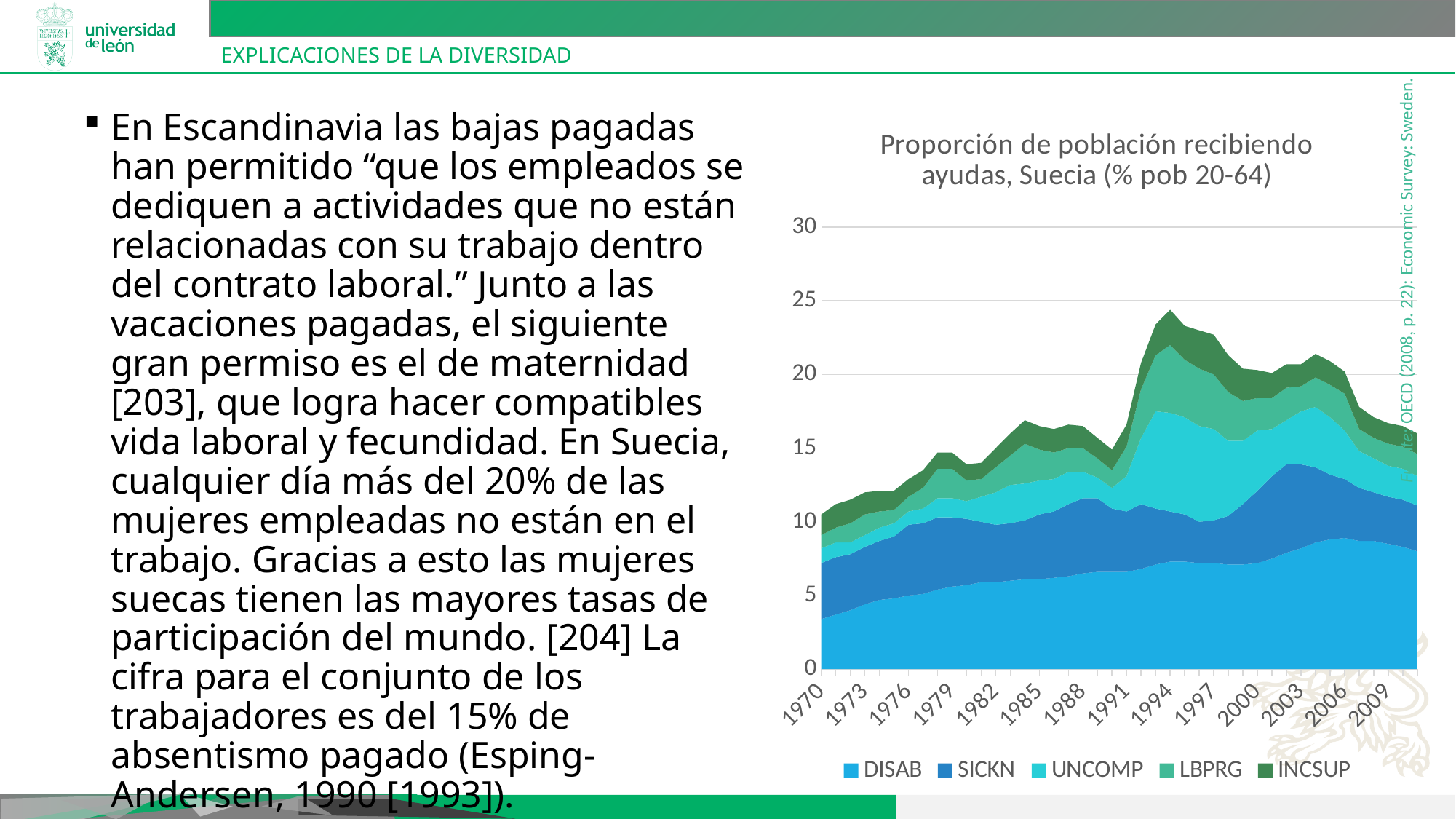
Is the total value for 1994 greater or less than 20? greater Does the total proportion rise or fall between 1970 and 1994? Rises Is the total value for 1994 larger or smaller than the total value for 1970? Larger In which year is the total proportion of population receiving aid lowest? 1970 How many year labels are shown on the x axis? 14 Which series is listed first in the chart legend? DISAB Is the total value for 1985 greater or less than 10? greater In which year does the total proportion of population receiving aid reach its highest point? 1994 Is the total value for 1970 greater or less than 15? less What is the title of the chart? Proporción de población recibiendo ayudas, Suecia (% pob 20-64) What kind of chart is shown on the slide? Stacked area chart How many series does the legend of the chart list? 5